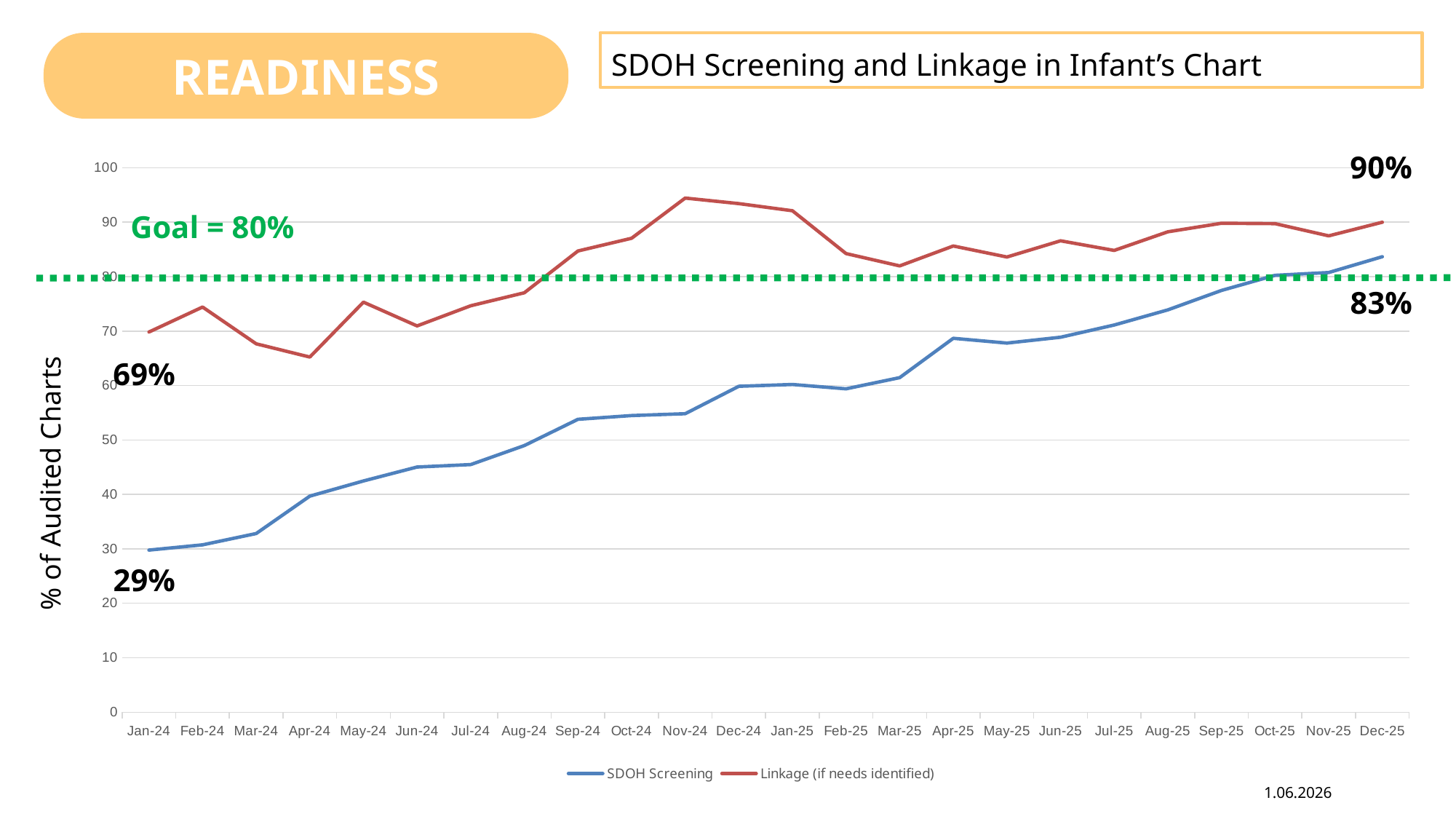
What is the SDOH Screening value for Dec-25? 83% How many series does the legend list? 2 What is the Linkage (if needs identified) value for Jan-24? 69% By how much did SDOH Screening increase from Jan-24 to Dec-25? 54% What kind of chart is shown on the slide? line chart In which month does the Linkage (if needs identified) line reach its highest value? Nov-24 How many months are plotted along the x axis? 24 Which series has the higher value in Dec-25, SDOH Screening or Linkage (if needs identified)? Linkage (if needs identified) What is the SDOH Screening value for Jan-24? 29% Is the SDOH Screening value for Nov-24 greater or less than 60? less What is the Linkage (if needs identified) value for Dec-25? 90% What goal value is marked by the dotted green line? 80%